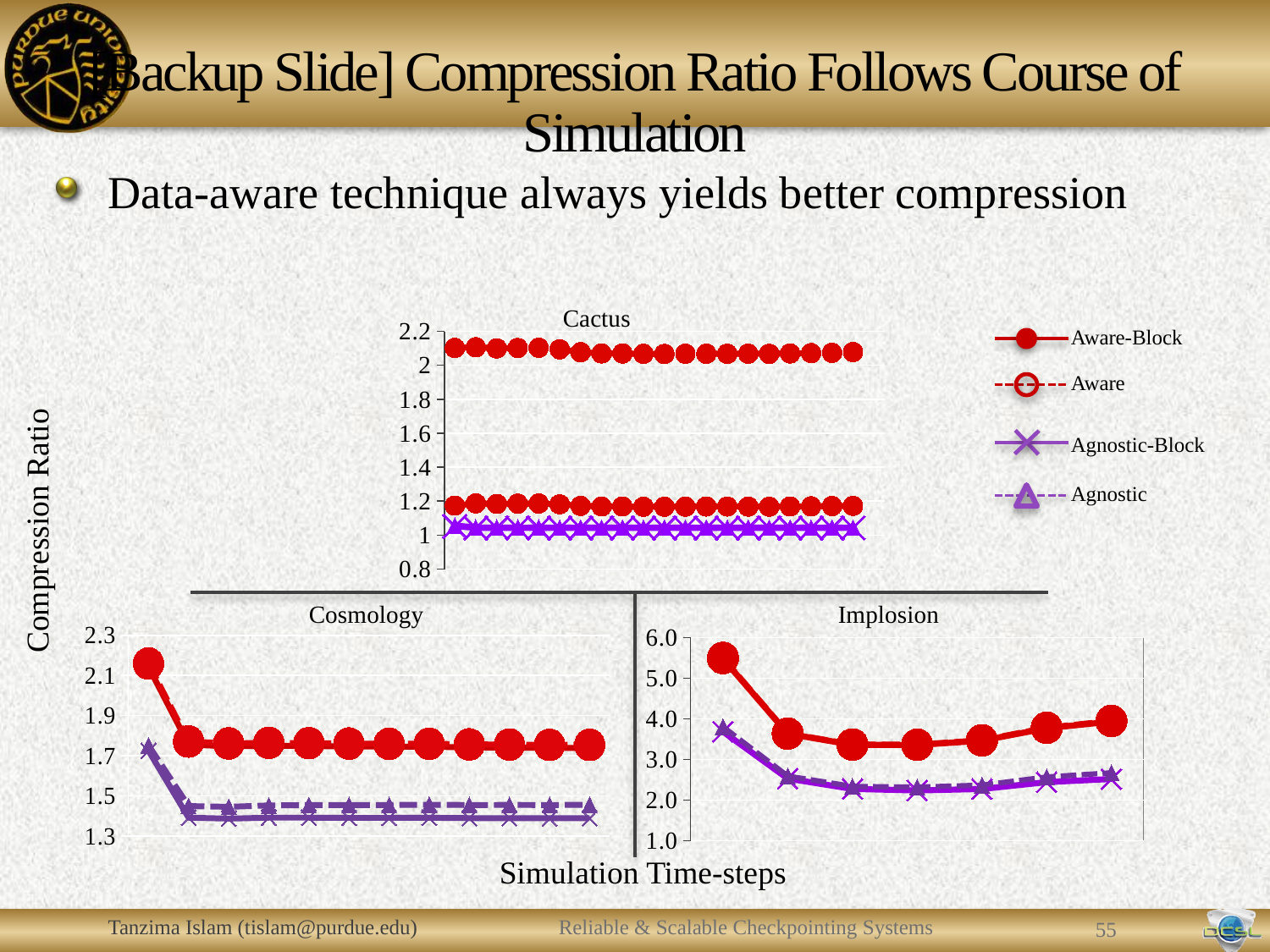
In the Implosion chart, is the value for Agnostic-Block at the last time-step greater or less than 3.0? less In the Cactus chart, which series has higher values, Aware-Block or Agnostic-Block? Aware-Block In the Implosion chart, is the first Aware-Block value greater or less than 5.0? greater What kind of chart is the Cactus chart? line chart In the Cosmology chart, is the first Aware-Block value greater or less than 1.9? greater How many series does the legend list? 4 What is the label of the shared y axis for the charts? Compression Ratio How many charts are shown on the slide? 3 In the Cosmology chart, do the Aware-Block values rise or fall from the first time-step to the second? fall